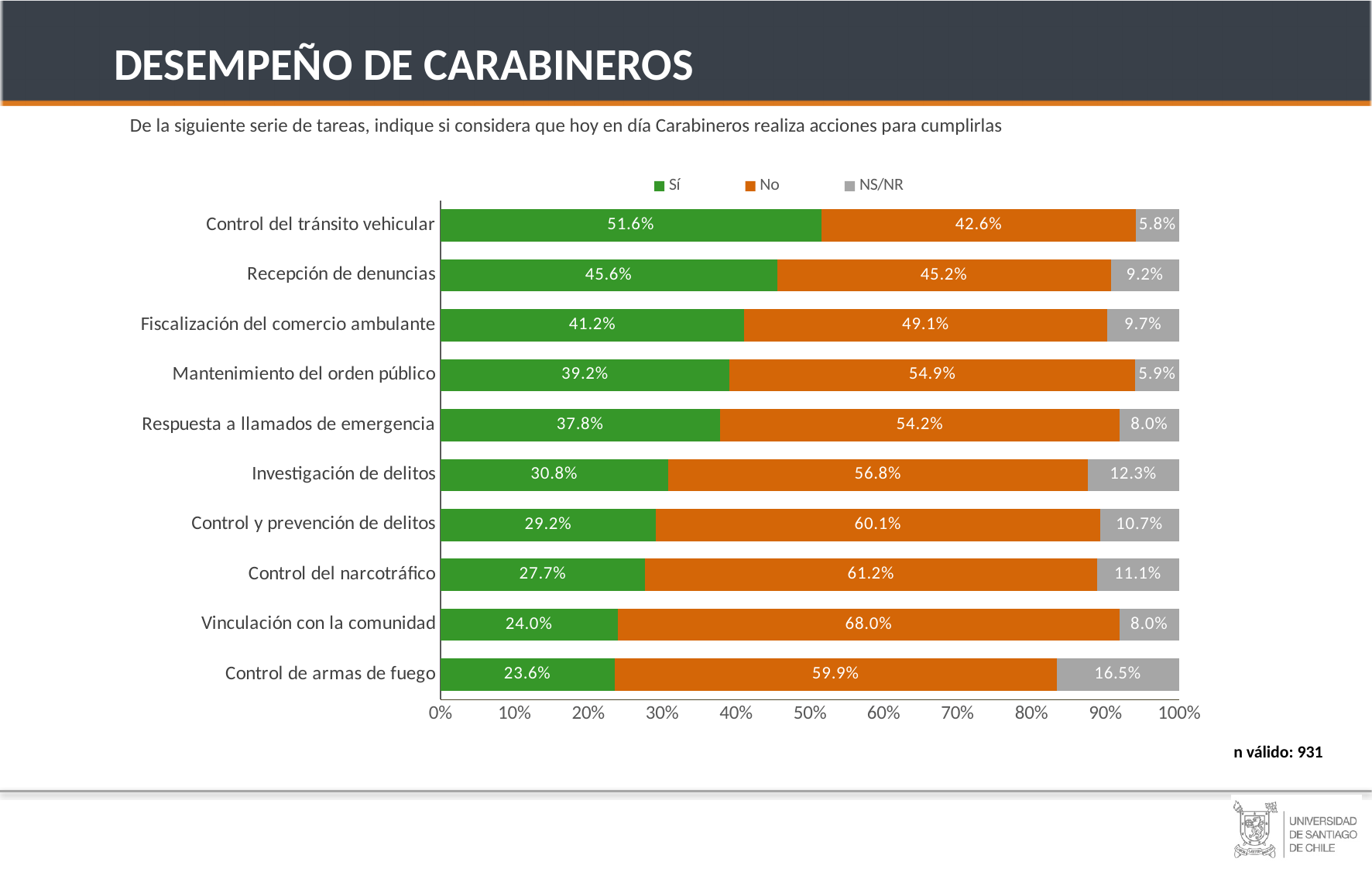
What is the 'n válido' shown on the slide? 931 Which category has the lowest 'Sí' value? Control de armas de fuego Which category has the highest 'Sí' value? Control del tránsito vehicular What kind of chart is shown on the slide? Stacked bar chart What is the 'No' value for Vinculación con la comunidad? 68.0% What is the difference between the 'No' and 'Sí' values for Investigación de delitos? 26.0% What is the 'NS/NR' value for Control de armas de fuego? 16.5% How many series does the legend list? 3 Which category has the highest 'No' value? Vinculación con la comunidad What is the 'Sí' value for Control del tránsito vehicular? 51.6% Which is larger for Recepción de denuncias, the 'Sí' value or the 'No' value? Sí How many categories (tasks) are shown in the chart? 10